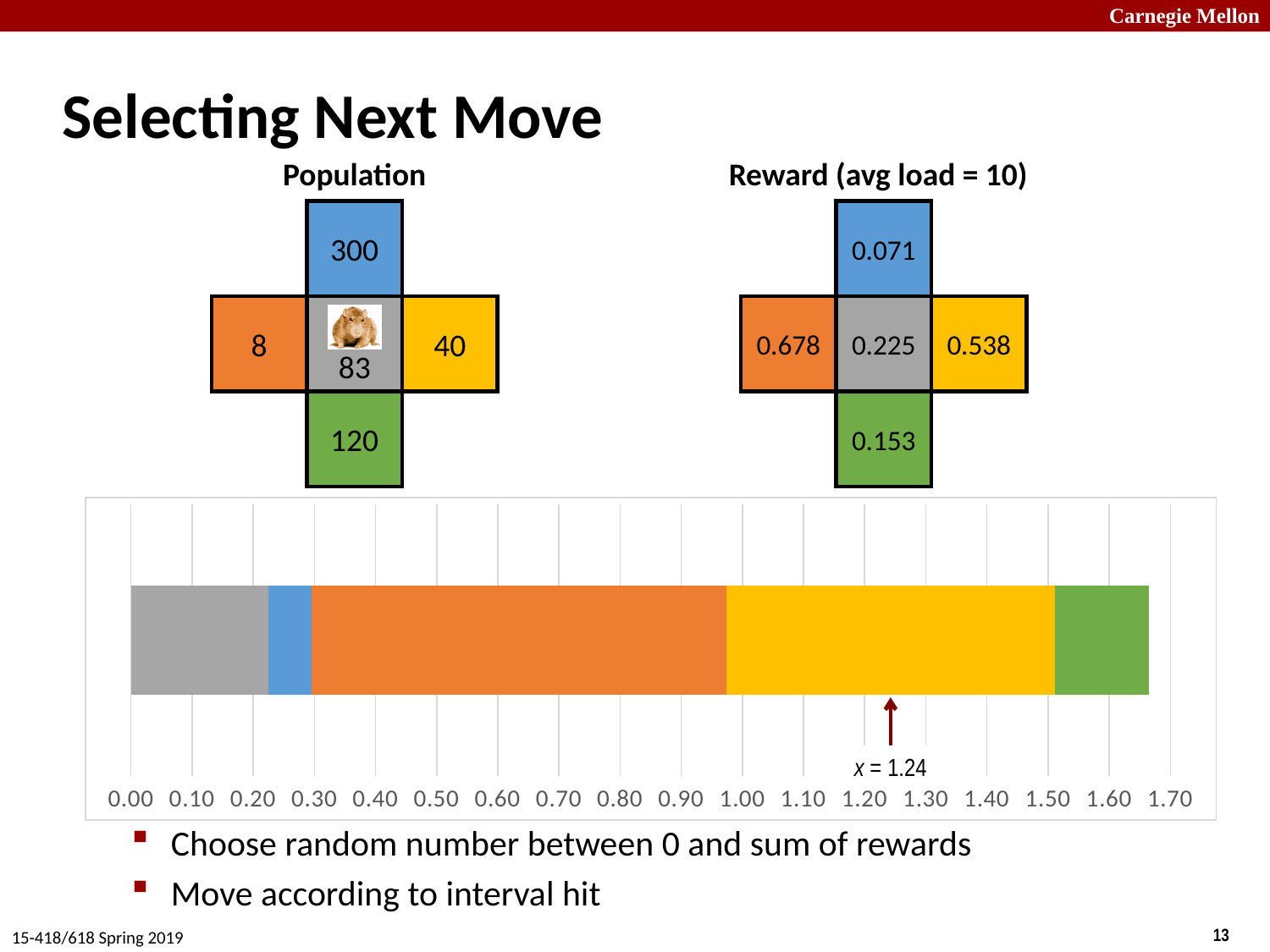
Which segment is wider, the gray one or the green one? gray Which coloured segment of the stacked bar is the widest? orange How many coloured segments make up the stacked bar in the chart? 5 What kind of chart is shown at the bottom of the slide? bar chart Is the right end of the gray segment greater or less than 0.20 on the axis? greater Which coloured segment does the arrow at x = 1.24 point to? yellow Which coloured segment of the stacked bar is the narrowest? blue Is the total length of the stacked bar greater or less than 1.60? greater Is the right end of the orange segment greater or less than 1.00 on the axis? less Which segment is wider, the orange one or the yellow one? orange What value is marked by the arrow annotation below the stacked bar? x = 1.24 What is the largest tick value shown on the chart's x axis? 1.70